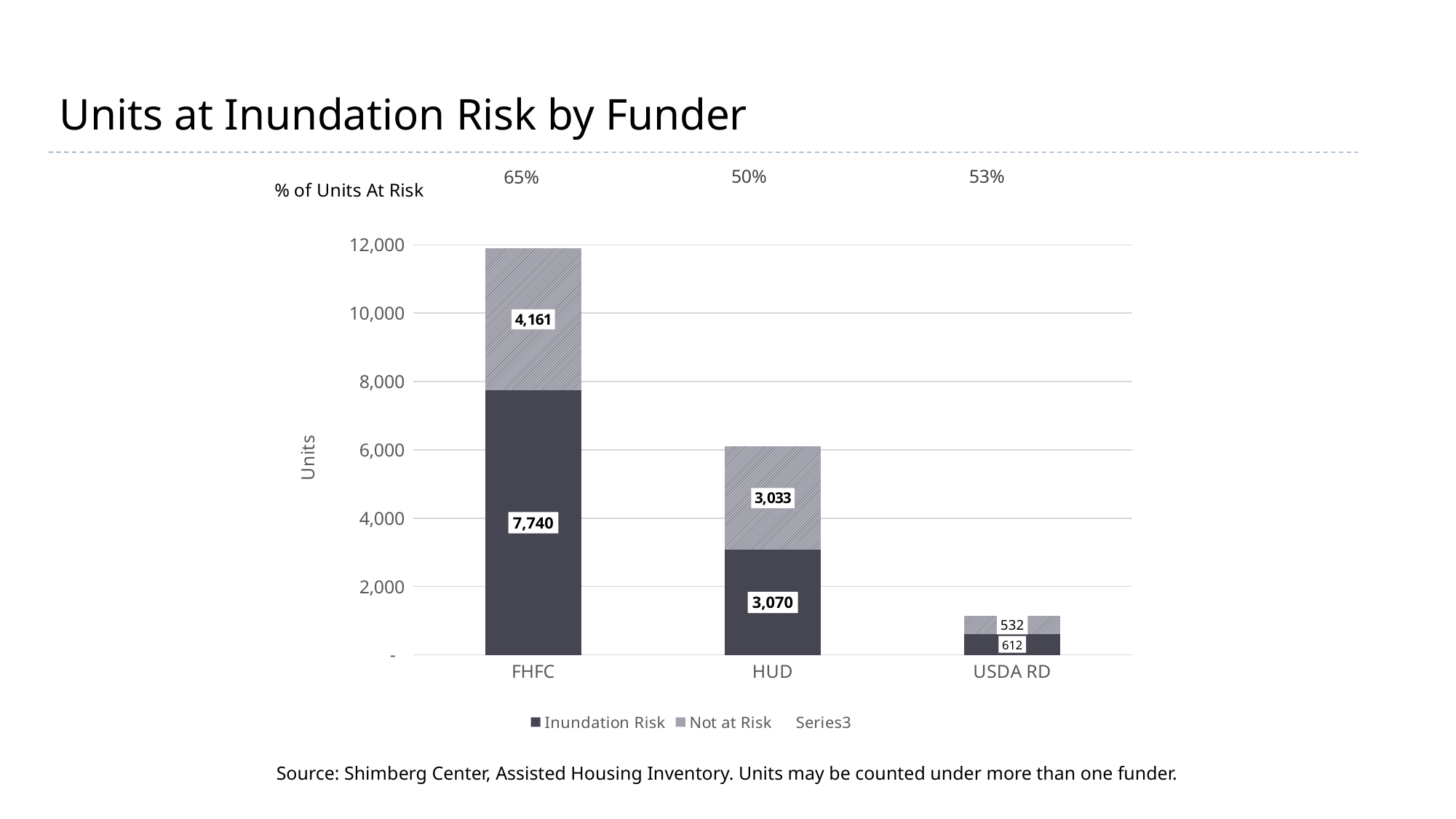
What is the Inundation Risk value for FHFC? 7,740 Which funder has the highest Inundation Risk value? FHFC Which is larger for USDA RD: the Inundation Risk value or the Not at Risk value? Inundation Risk What is the total of the stacked bar for USDA RD? 1,144 What percentage of units at risk is shown above the HUD bar? 50% What is the Inundation Risk value for USDA RD? 612 Which funder has the lowest Not at Risk value? USDA RD What is the Not at Risk value for HUD? 3,033 How many series does the legend list? 3 What is the difference between the Inundation Risk values for FHFC and HUD? 4,670 How many funders are shown on the x axis? 3 What is the total of the stacked bar for HUD? 6,103